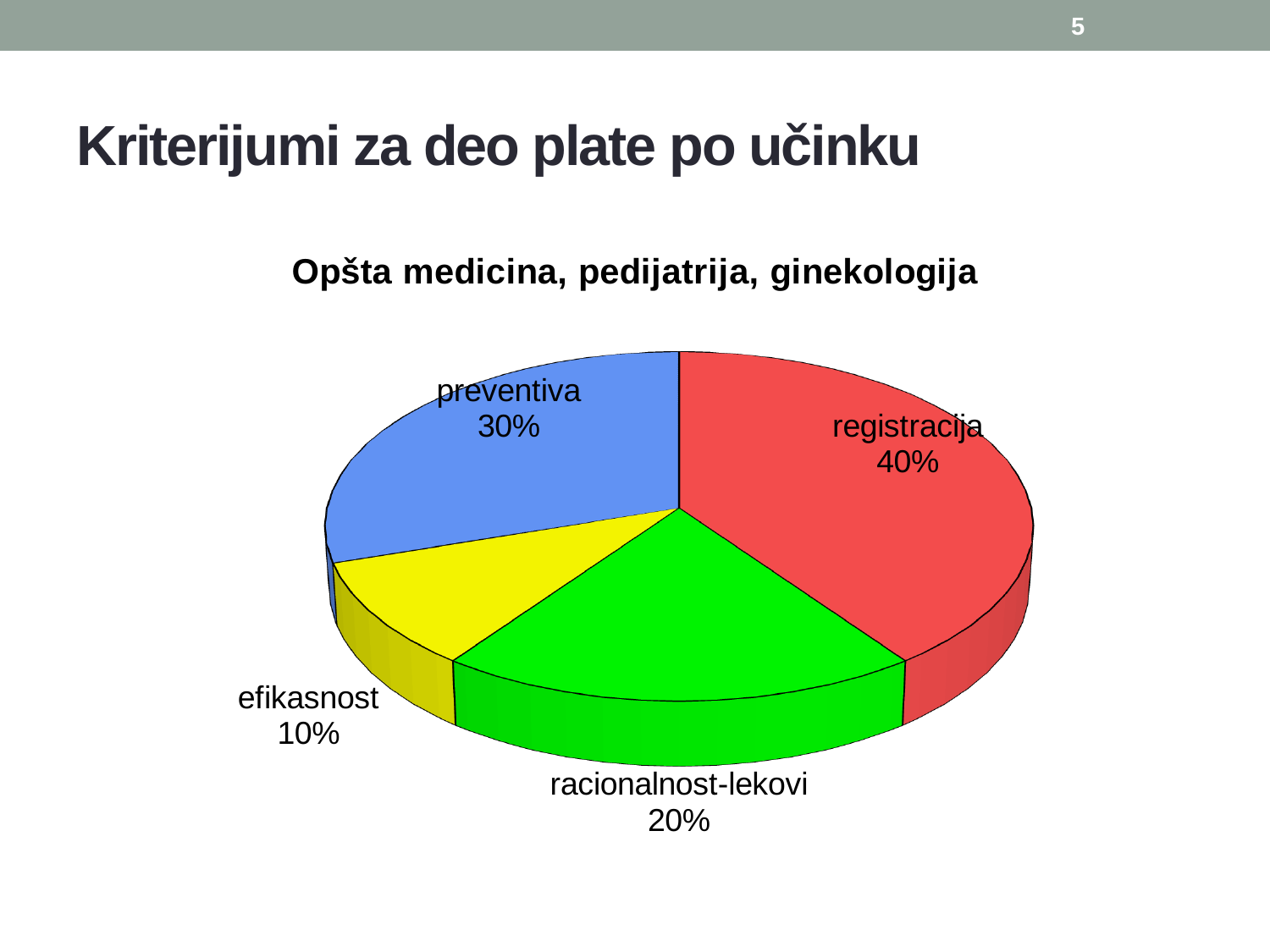
What is the difference between the shares of registracija and efikasnost? 30% What share of the pie does registracija have? 40% What share of the pie does preventiva have? 30% What share of the pie does efikasnost have? 10% Which category has the smallest slice of the pie? efikasnost What is the difference between the shares of preventiva and racionalnost-lekovi? 10% What kind of chart is shown on the slide? pie chart Which is larger, the share of preventiva or the share of racionalnost-lekovi? preventiva Which category has the largest slice of the pie? registracija How many categories are shown in the pie chart? 4 What is the title of the chart? Opšta medicina, pedijatrija, ginekologija